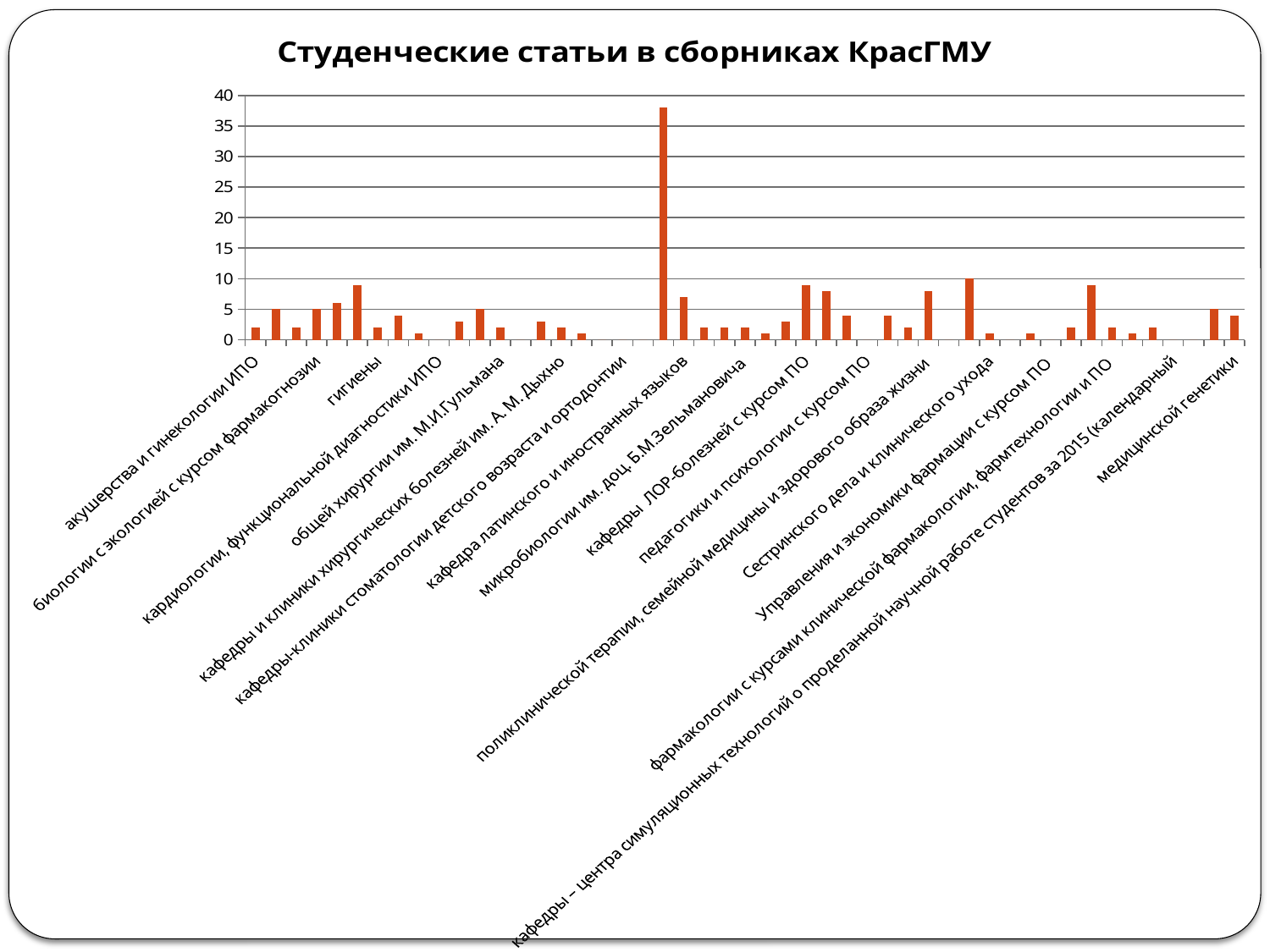
Is the value for медицинской генетики greater or less than 10? less Which is larger, the value for кафедры ЛОР-болезней с курсом ПО or the value for акушерства и гинекологии ИПО? кафедры ЛОР-болезней с курсом ПО What is the highest value shown on the vertical axis? 40 What is the title of the chart? Студенческие статьи в сборниках КрасГМУ Is the value for акушерства и гинекологии ИПО greater or less than 5? less Is the value of the tallest bar in the chart greater or less than 35? greater What kind of chart is shown on the slide? bar chart